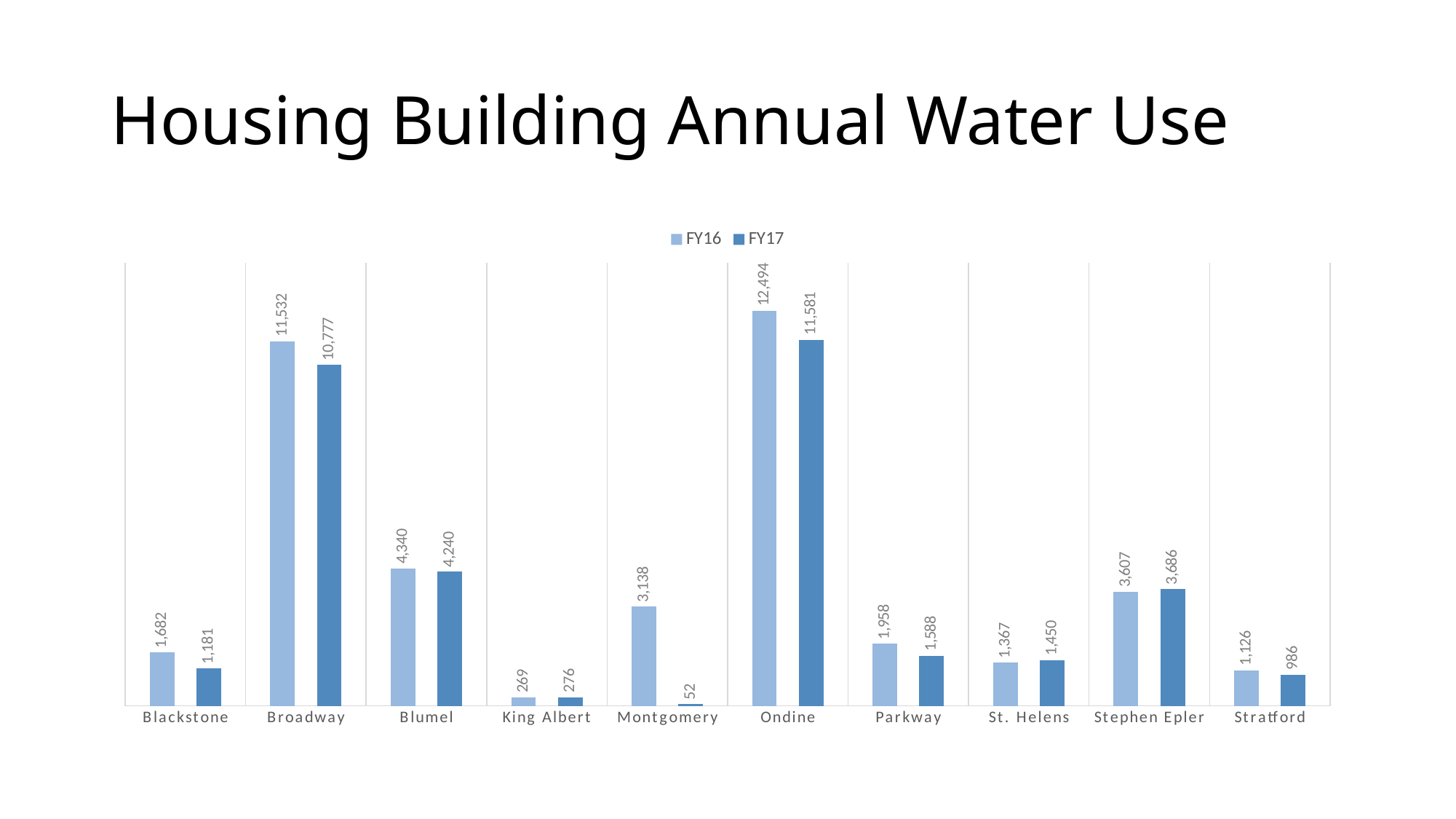
What is the difference between the FY16 and FY17 values for Ondine? 913 Which building has the highest FY16 value? Ondine Which is larger for Blumel, the FY16 value or the FY17 value? FY16 How many series does the legend list? 2 What kind of chart is shown on the slide? Bar chart What is the difference between the FY16 and FY17 values for Parkway? 370 What is the FY16 value for Broadway? 11,532 What is the FY17 value for Montgomery? 52 What is the FY17 value for Stephen Epler? 3,686 How many buildings are shown on the x axis? 10 Which is larger for St. Helens, the FY16 value or the FY17 value? FY17 Which building has the lowest FY17 value? Montgomery